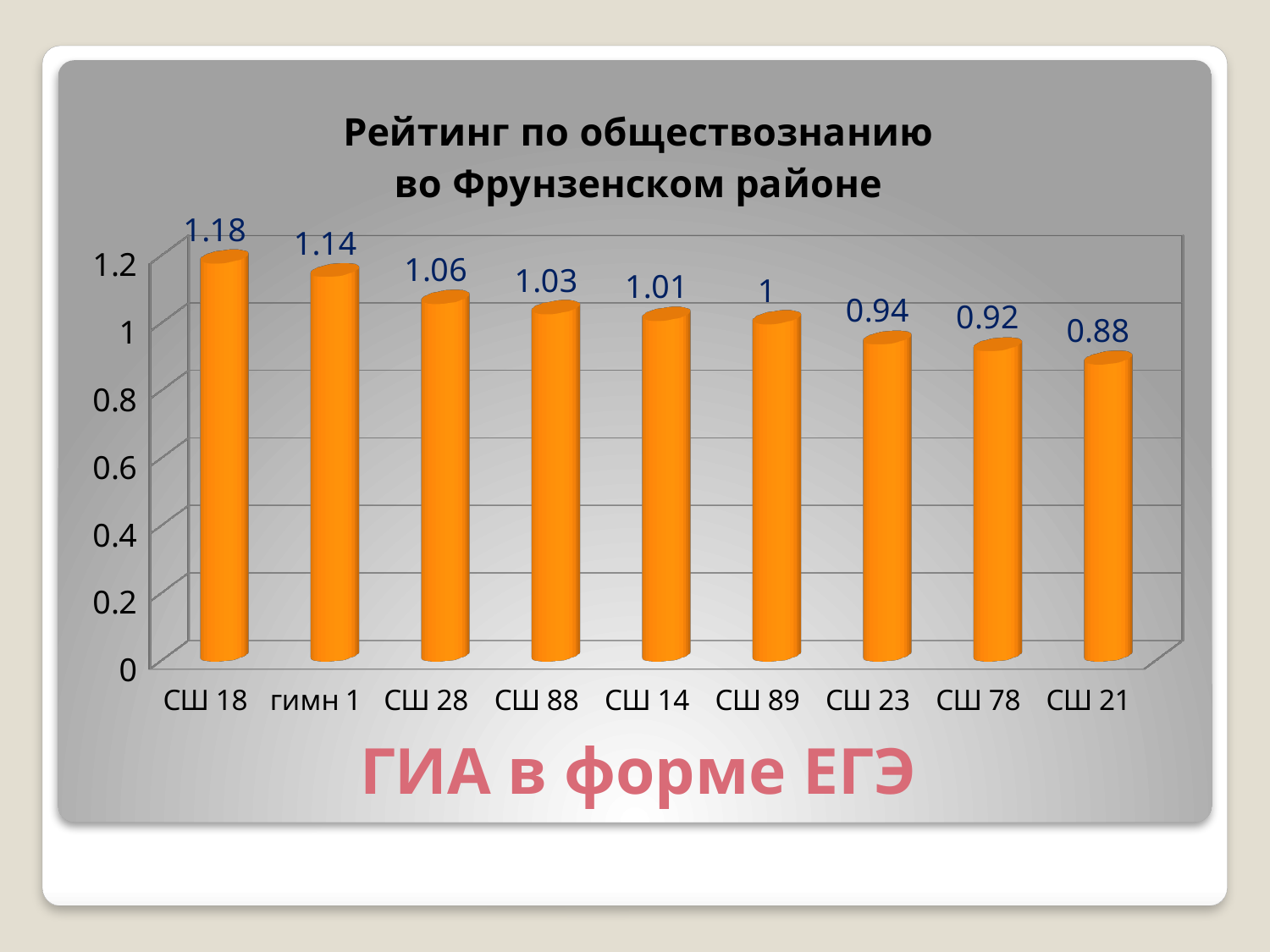
Which is larger, the value for СШ 28 or the value for СШ 23? СШ 28 What is the value for гимн 1? 1.14 Which school has the lowest rating? СШ 21 What is the value for СШ 21? 0.88 What kind of chart is this? Bar chart Do the values rise or fall from left to right along the x axis? Fall What is the difference between the values for СШ 18 and СШ 21? 0.3 What is the value for СШ 18? 1.18 What is the value for СШ 89? 1 How many schools are shown on the chart? 9 Which school has the highest rating? СШ 18 What is the title of the chart? Рейтинг по обществознанию во Фрунзенском районе